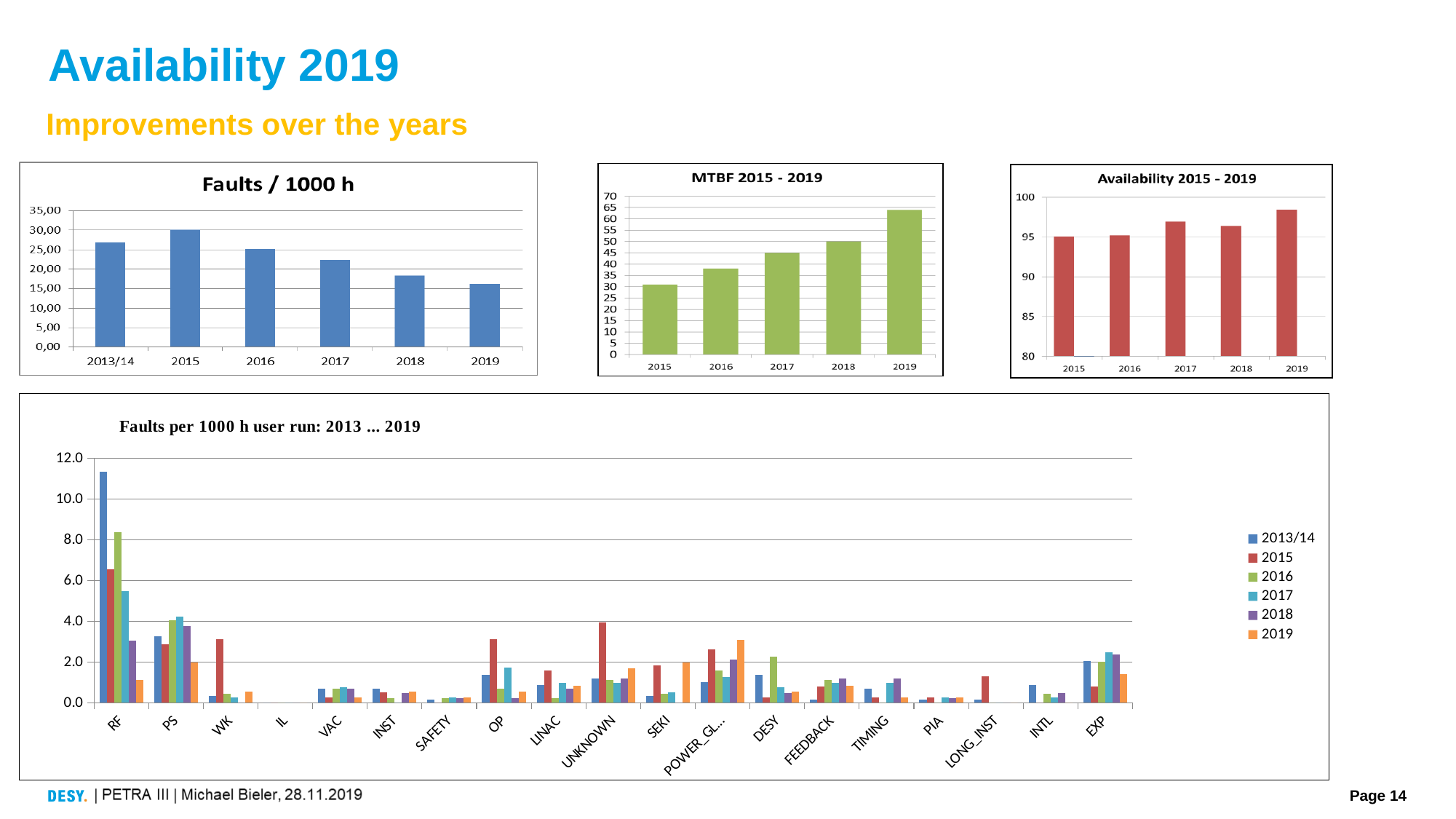
In the 'Faults / 1000 h' chart, which year has the lowest value? 2019 How many series does the legend of the 'Faults per 1000 h user run: 2013 ... 2019' chart list? 6 In the 'Faults / 1000 h' chart, is the value for 2019 greater or less than 20,00? less How many bars are shown in the 'Faults / 1000 h' chart? 6 In the 'Availability 2015 - 2019' chart, which year has the highest value? 2019 In the 'Faults / 1000 h' chart, which year has the highest value? 2015 In the 'MTBF 2015 - 2019' chart, is the value for 2019 greater or less than 60? greater What kind of chart is the 'Faults per 1000 h user run: 2013 ... 2019' chart? bar chart In the 'MTBF 2015 - 2019' chart, which year has the lowest value? 2015 In the 'MTBF 2015 - 2019' chart, do the values rise or fall from 2015 to 2019? rise In the 'Availability 2015 - 2019' chart, is the value for 2016 greater or less than 90? greater In the 'Faults per 1000 h user run: 2013 ... 2019' chart, which is larger for RF: the 2013/14 value or the 2015 value? 2013/14